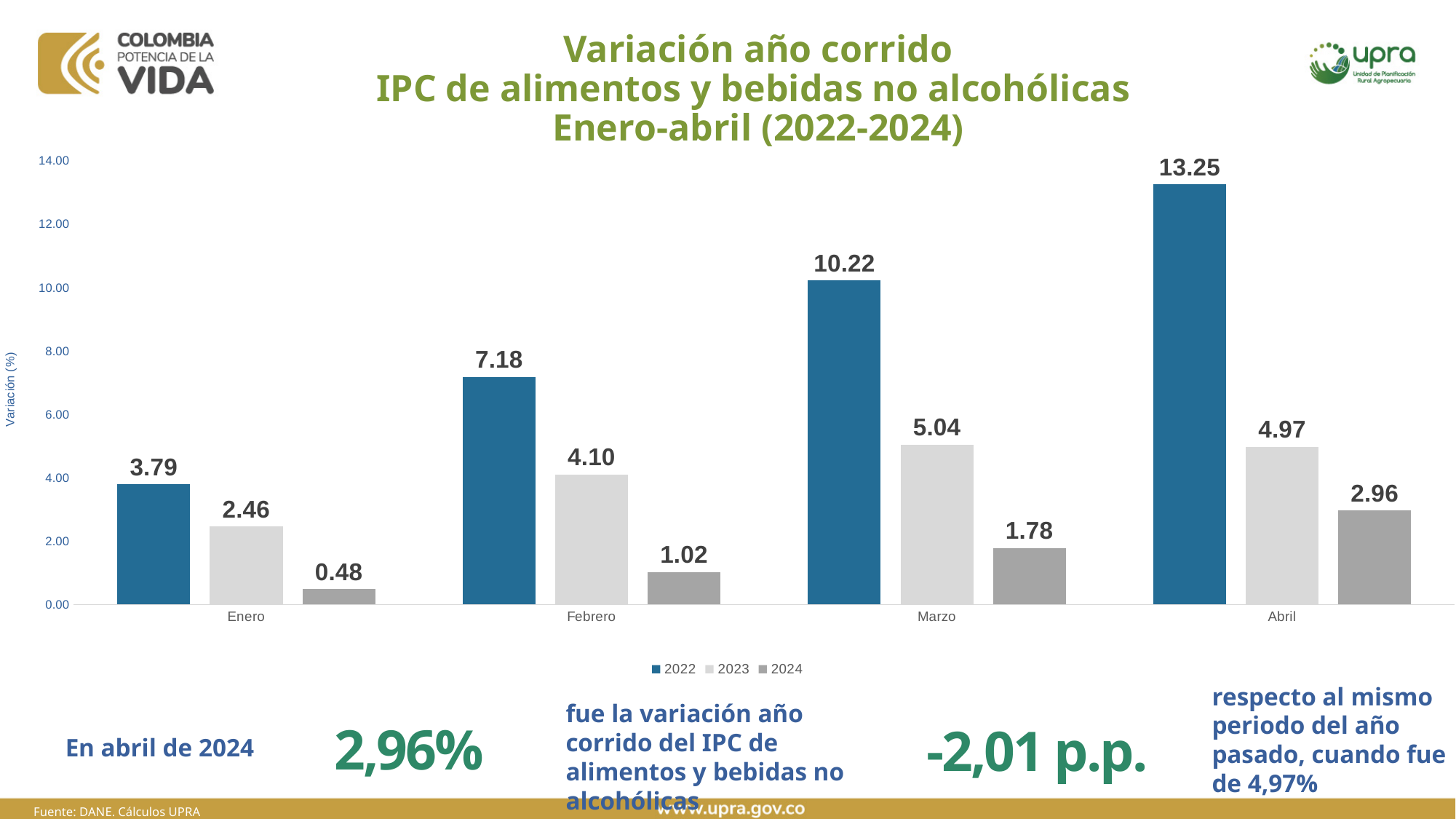
What is the value for 2024 in Enero? 0.48 What is the value for 2023 in Marzo? 5.04 What kind of chart is shown on the slide? Bar chart What is the difference between the 2023 and 2024 values in Abril? 2.01 How many series does the legend list? 3 What is the value for 2022 in Abril? 13.25 How many months are shown on the x axis? 4 Is the value for 2022 in Marzo greater or less than 10.00? greater Do the values for the 2024 series rise or fall from Enero to Abril? Rise Which month has the lowest value for the 2024 series? Enero Which month has the highest value for the 2022 series? Abril Which is larger in Febrero: the 2022 value or the 2023 value? 2022